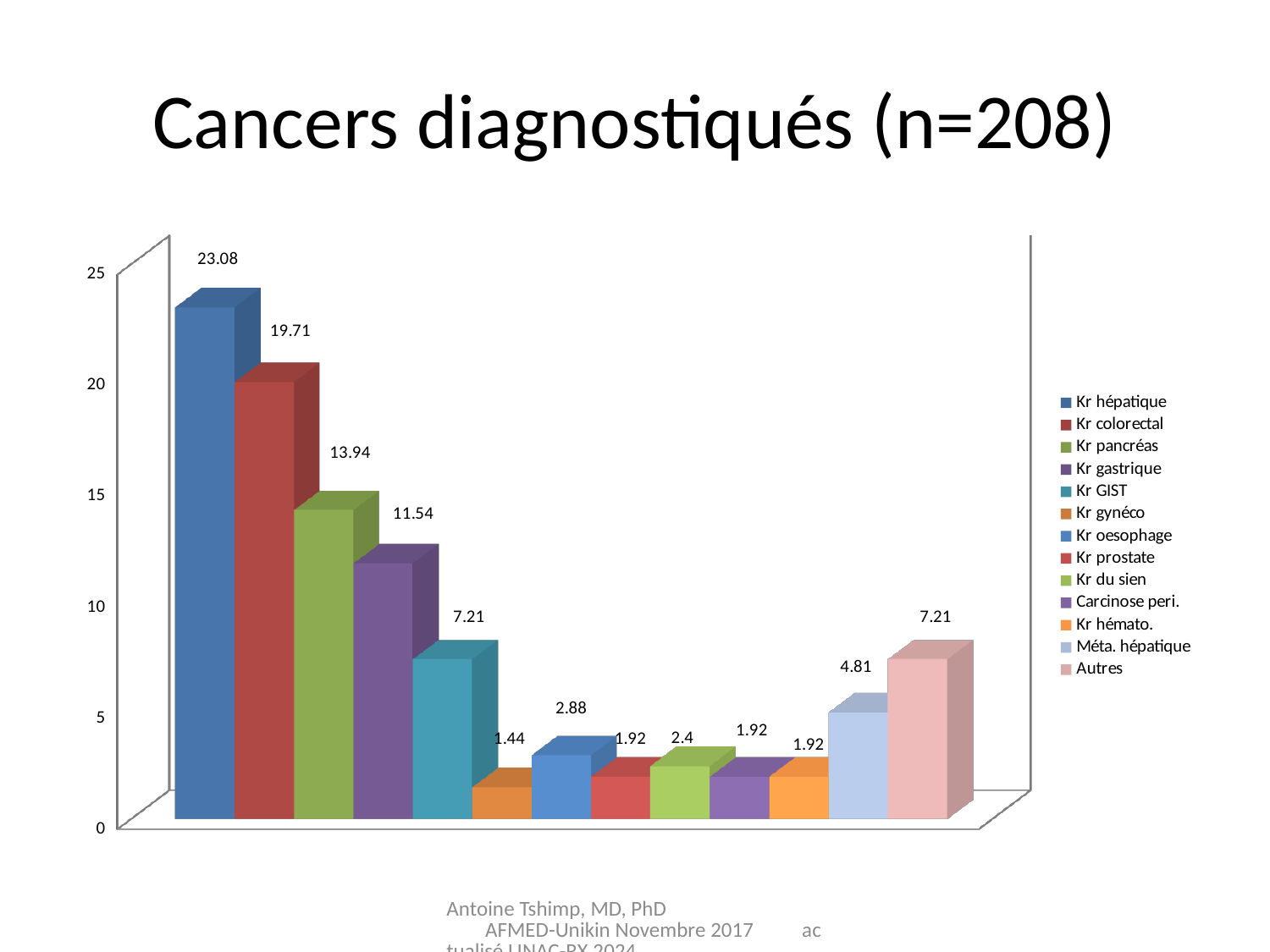
What is the value shown for Kr colorectal? 19.71 What is the value shown for Kr hépatique? 23.08 Is the value for Kr pancréas greater or less than 10? greater What is the value shown for Méta. hépatique? 4.81 What is the value shown for Kr pancréas? 13.94 Which category has the lowest value? Kr gynéco What kind of chart is shown on the slide? Bar chart Which is larger, the value for Kr gastrique or the value for Kr GIST? Kr gastrique Which category has the highest value? Kr hépatique What is the difference between the values for Kr hépatique and Kr colorectal? 3.37 How many bars are plotted in the chart? 13 How many entries does the legend list? 13